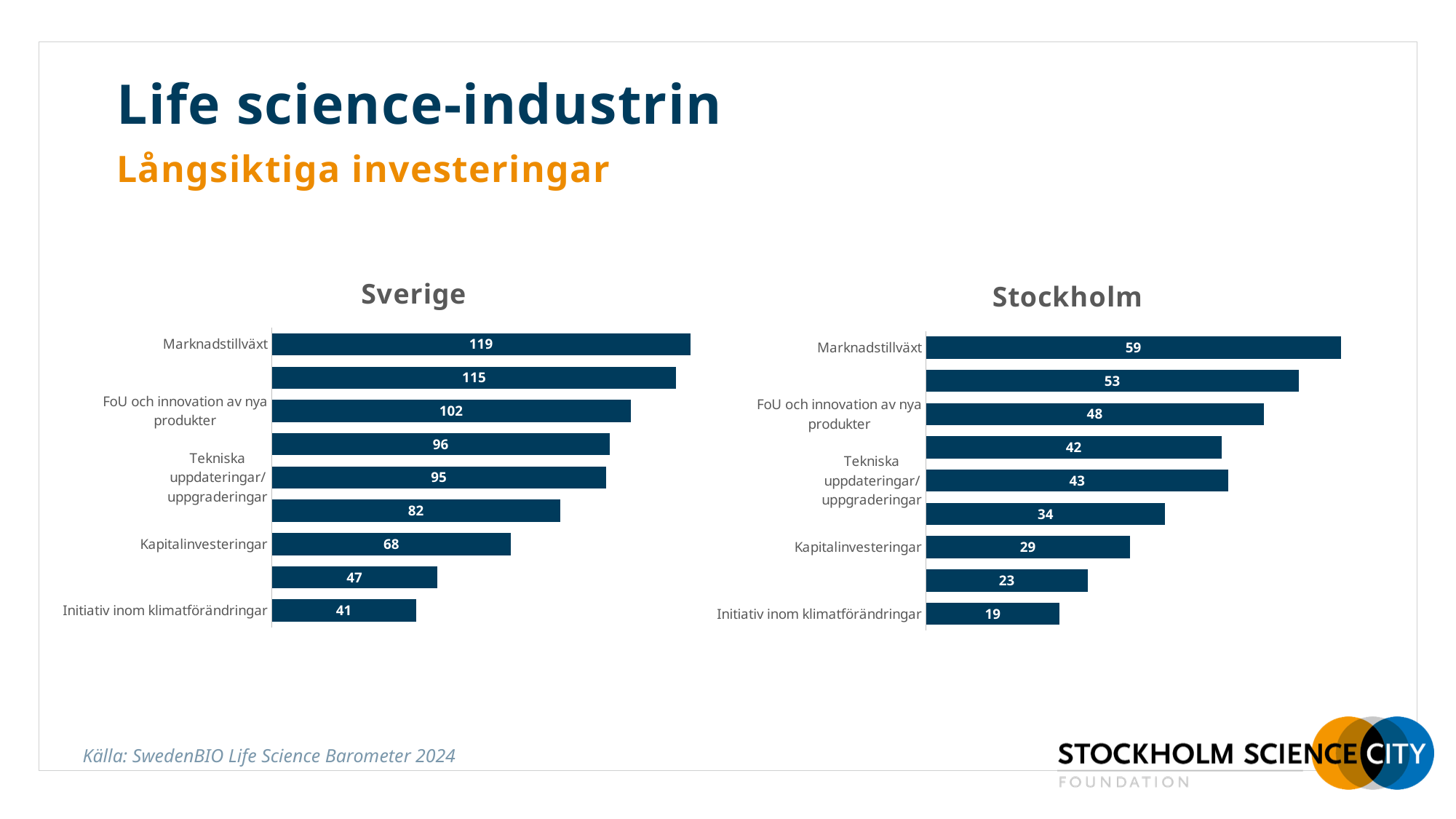
In the Sverige chart, what is the value for Marknadstillväxt? 119 Which is larger: the value for Kapitalinvesteringar in the Sverige chart or in the Stockholm chart? Sverige In the Stockholm chart, what is the difference between the values for FoU och innovation av nya produkter and Kapitalinvesteringar? 19 In the Sverige chart, which category has the highest value? Marknadstillväxt In the Stockholm chart, which category has the lowest value? Initiativ inom klimatförändringar What kind of chart is the Stockholm chart? Bar chart In the Sverige chart, what is the value for Kapitalinvesteringar? 68 What is the title of the chart on the left side of the slide? Sverige In the Sverige chart, what is the difference between the values for Marknadstillväxt and Initiativ inom klimatförändringar? 78 How many bars are plotted in the Sverige chart? 9 In the Stockholm chart, what is the value for Initiativ inom klimatförändringar? 19 In the Stockholm chart, what is the value for Marknadstillväxt? 59